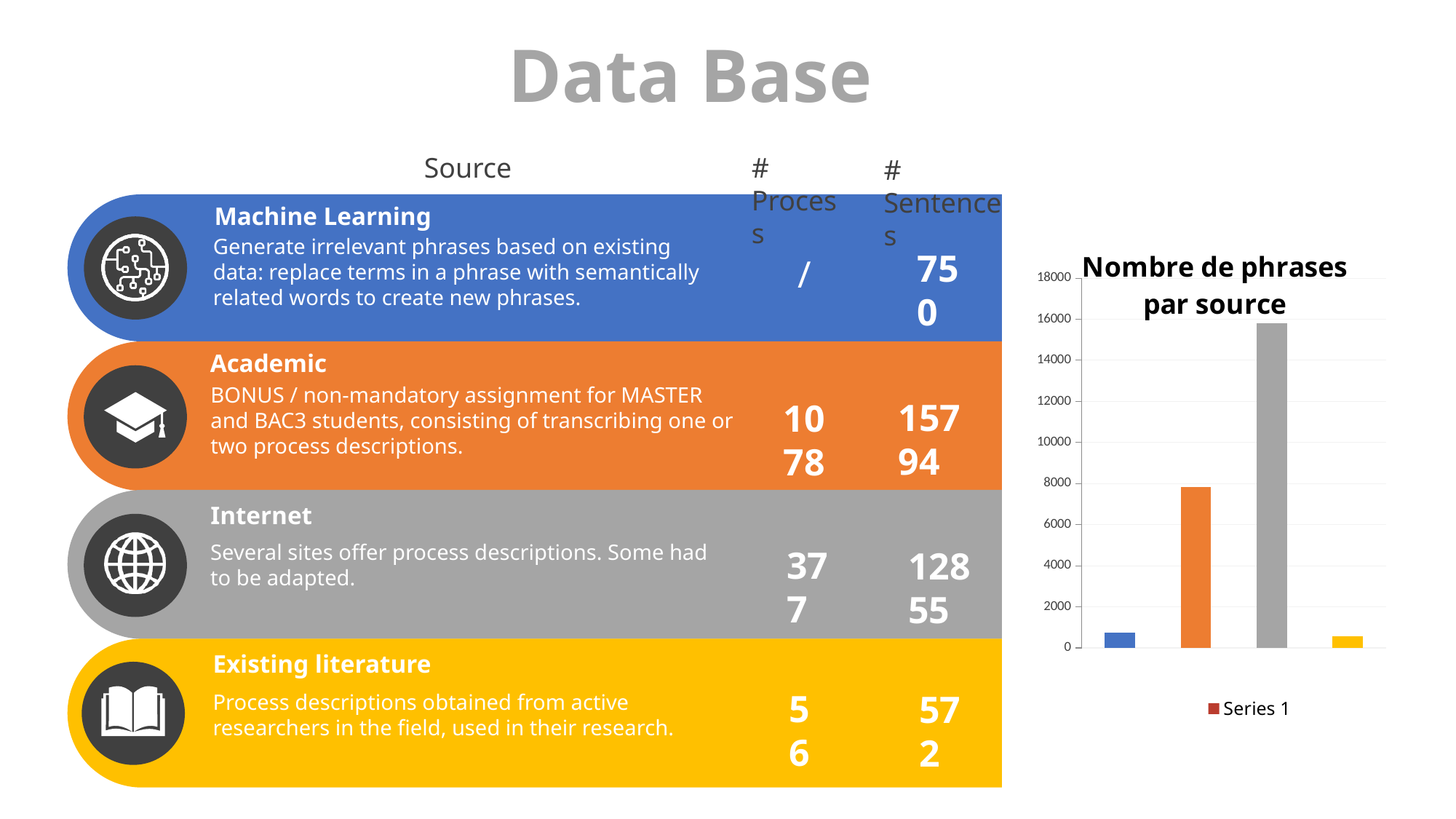
What kind of chart is shown on the right of the slide? bar chart In the chart 'Nombre de phrases par source', is the value of the third (gray) bar greater or less than 14000? greater In the chart 'Nombre de phrases par source', is the value of the first (blue) bar greater or less than 2000? less In the chart 'Nombre de phrases par source', is the value of the second (orange) bar greater or less than 6000? greater How many series does the legend of the chart 'Nombre de phrases par source' list? 1 What is the title of the chart on the slide? Nombre de phrases par source What is the legend entry shown below the chart 'Nombre de phrases par source'? Series 1 How many bars are plotted in the chart 'Nombre de phrases par source'? 4 In the chart 'Nombre de phrases par source', which is larger: the first (blue) bar or the second (orange) bar? the second (orange) bar In the chart 'Nombre de phrases par source', which bar is the tallest? the third (gray) bar In the chart 'Nombre de phrases par source', which is larger: the second (orange) bar or the third (gray) bar? the third (gray) bar